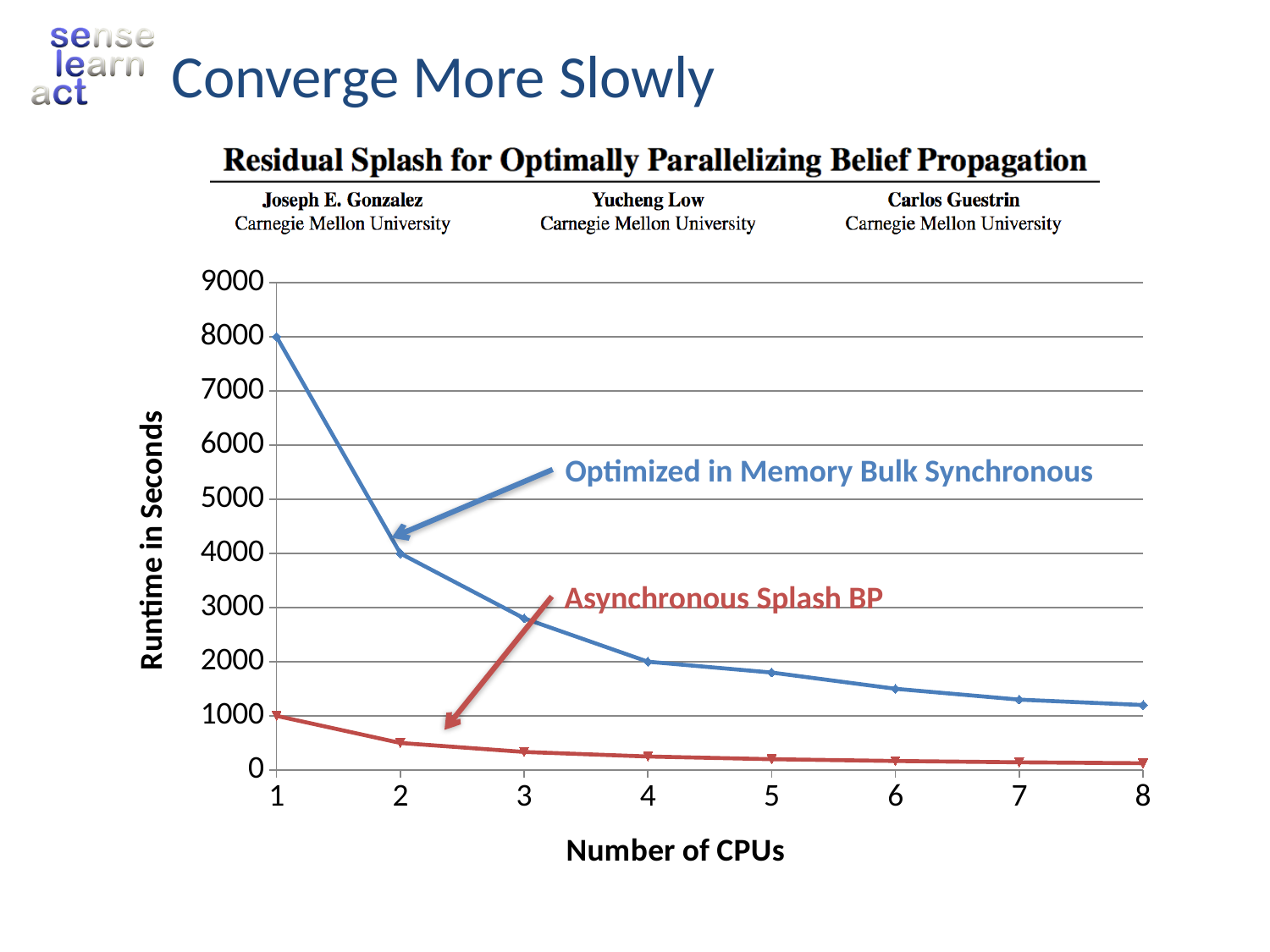
What kind of chart is shown on the slide? line chart How many series are plotted in the chart? 2 What is the label of the y axis? Runtime in Seconds Which series has the higher runtime at 4 CPUs? Optimized in Memory Bulk Synchronous What is the runtime in seconds for Asynchronous Splash BP at 1 CPU? 1000 How many CPU counts are plotted along the x axis? 8 At which number of CPUs is the runtime for Optimized in Memory Bulk Synchronous highest? 1 What is the runtime in seconds for Optimized in Memory Bulk Synchronous at 1 CPU? 8000 Is the runtime for Optimized in Memory Bulk Synchronous at 3 CPUs greater or less than 2000 seconds? greater Is the runtime for Asynchronous Splash BP at 8 CPUs greater or less than 1000 seconds? less Does the runtime for Asynchronous Splash BP rise or fall as the number of CPUs increases? fall